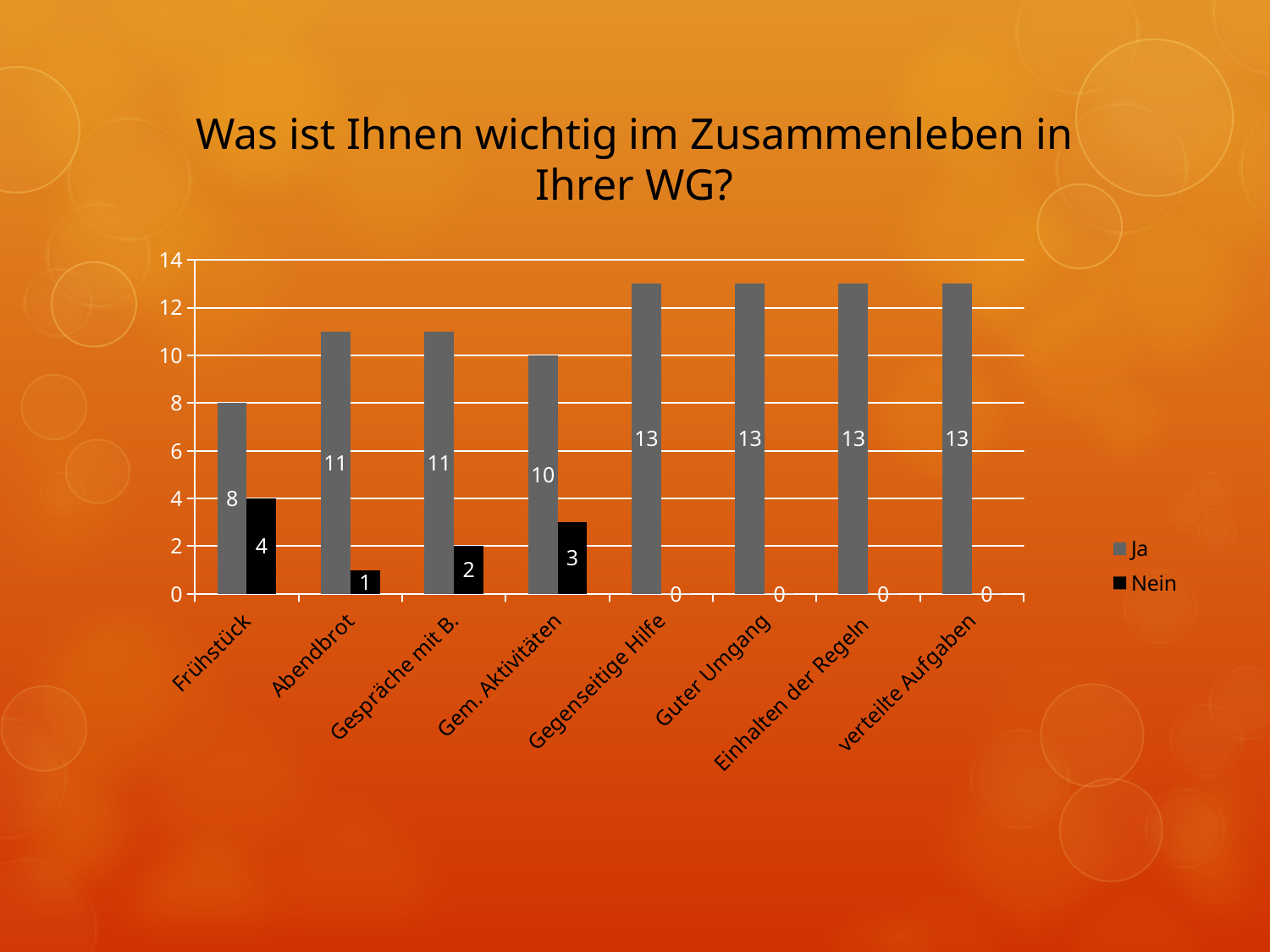
What is the difference between the 'Ja' and 'Nein' values for Frühstück? 4 What is the 'Nein' value for Gem. Aktivitäten? 3 How many categories are shown on the x axis? 8 What kind of chart is shown on the slide? Bar chart What is the 'Nein' value for Abendbrot? 1 Which category has the highest 'Nein' value? Frühstück What is the title of the chart? Was ist Ihnen wichtig im Zusammenleben in Ihrer WG? What is the total of the 'Ja' and 'Nein' values for Gespräche mit B.? 13 How many series does the legend list? 2 Which category has the lowest 'Ja' value? Frühstück Which is larger: the 'Ja' value for Abendbrot or the 'Ja' value for Gem. Aktivitäten? Abendbrot What is the 'Ja' value for Frühstück? 8